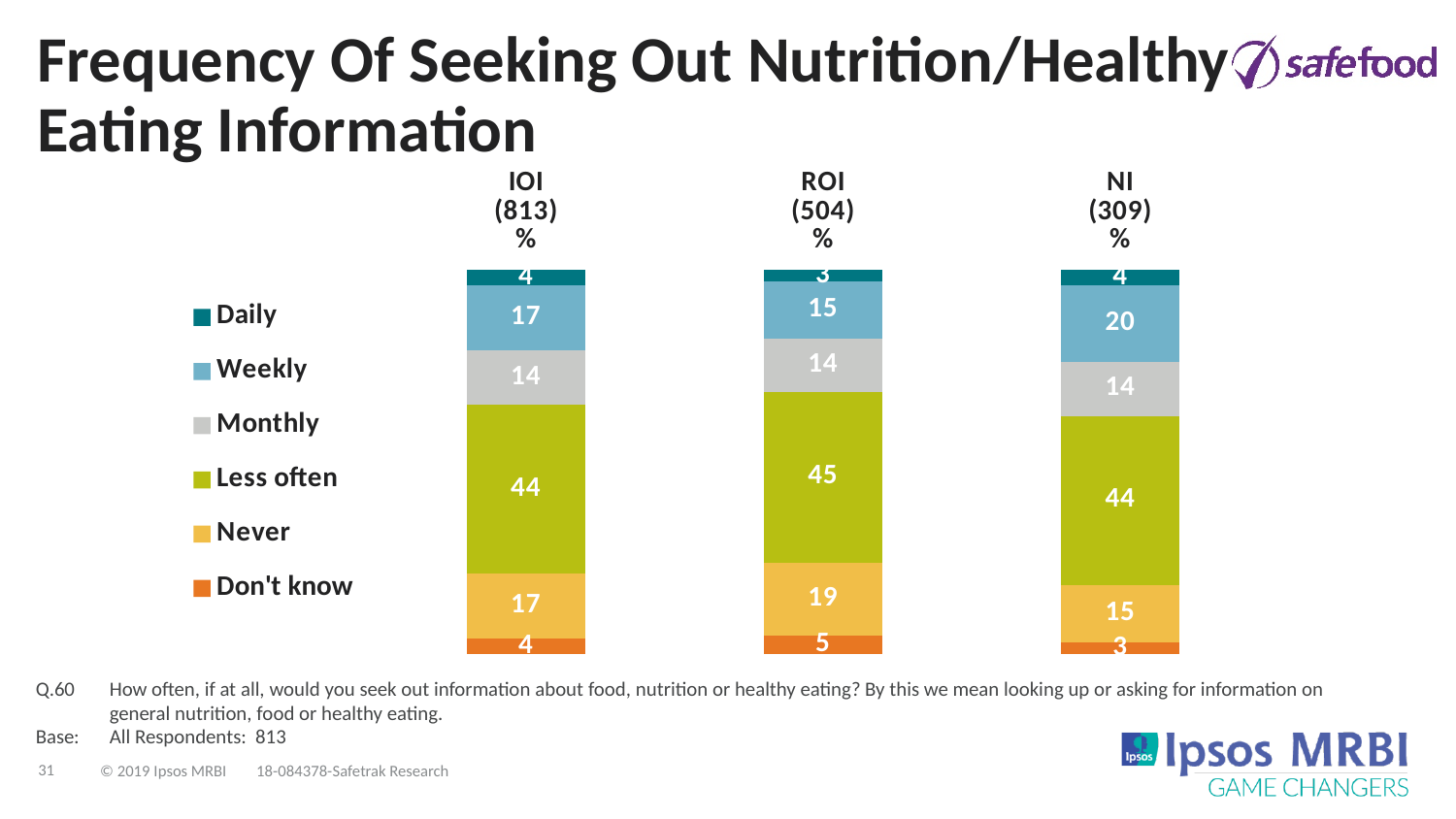
Which region has the highest 'Weekly' value? NI What is the difference between the 'Never' values for ROI and NI? 4 How many series does the legend list? 6 What is the 'Never' value for IOI? 17 How many bars (regions) are plotted in the chart? 3 What is the 'Weekly' value for NI? 20 What is the base size shown for ROI? 504 What kind of chart is shown on the slide? Stacked bar chart Which region has the lowest 'Never' value? NI Which is larger, the 'Weekly' value for IOI or for ROI? IOI What is the 'Less often' value for ROI? 45 What is the 'Don't know' value for ROI? 5